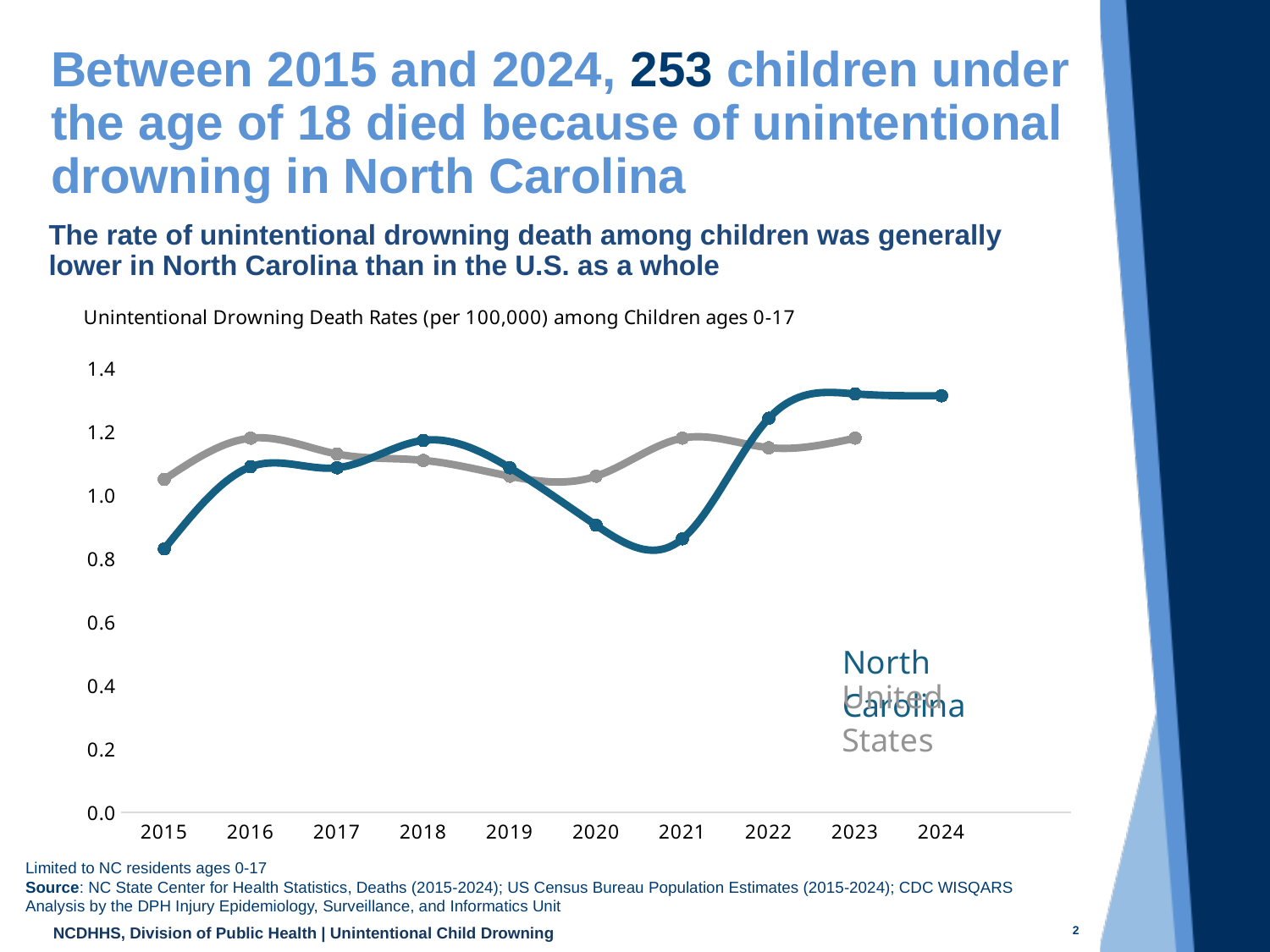
Is the North Carolina value for 2021 greater or less than 1.0? less In 2020, which series has the higher value, North Carolina or United States? United States What is the title of the chart? Unintentional Drowning Death Rates (per 100,000) among Children ages 0-17 Is the North Carolina value for 2015 greater or less than 1.0? less Is the North Carolina value for 2023 greater or less than 1.2? greater In 2023, which series has the higher value, North Carolina or United States? North Carolina Does the North Carolina line rise or fall between 2021 and 2023? rise In 2015, which series has the higher value, North Carolina or United States? United States How many years are shown along the x axis of the chart? 10 What kind of chart is shown on the slide? line chart